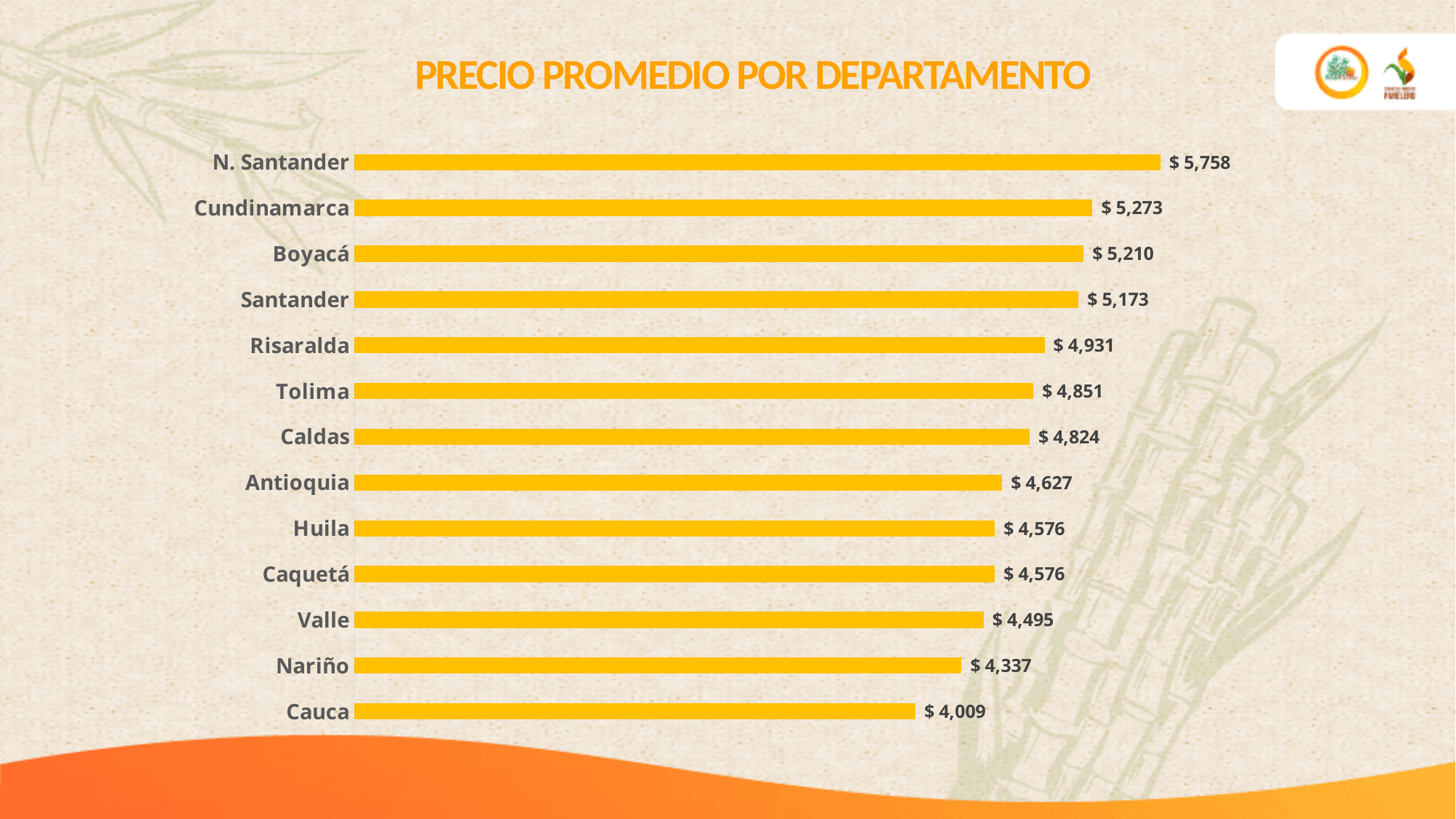
What is the average price for N. Santander? $ 5,758 What is the average price for Tolima? $ 4,851 What kind of chart is shown on the slide? Bar chart Which has a higher average price, Valle or Nariño? Valle Which department has the lowest average price? Cauca What is the difference between the average price for Cundinamarca and Boyacá? $ 63 What is the difference between the average price for N. Santander and Cauca? $ 1,749 Which department has the highest average price? N. Santander Which has a higher average price, Risaralda or Antioquia? Risaralda What is the title of the chart? PRECIO PROMEDIO POR DEPARTAMENTO How many departments are shown in the chart? 13 What is the average price for Cauca? $ 4,009